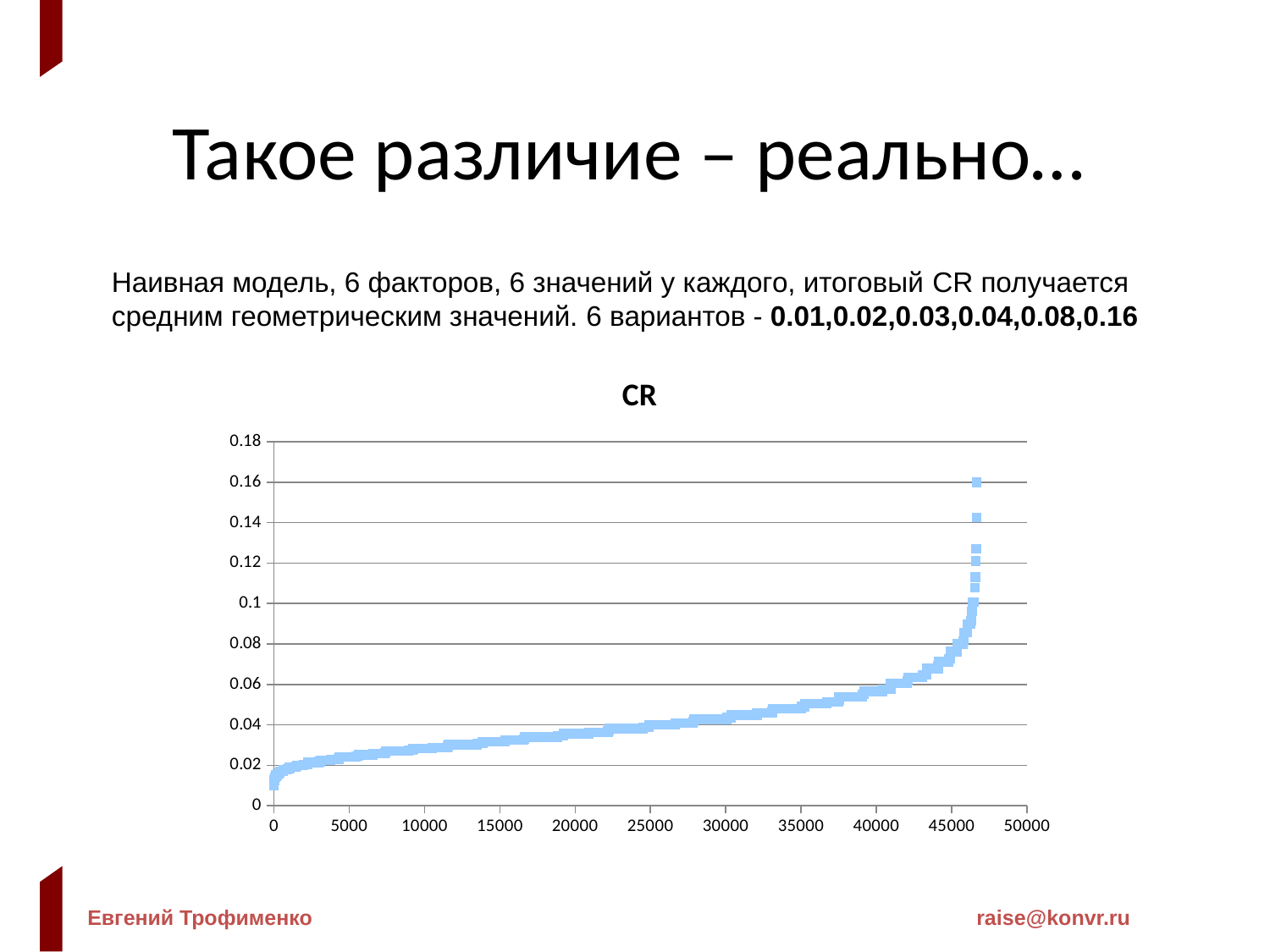
Is the plotted value at x = 30000 greater or less than 0.06? less What is the maximum value shown on the y axis? 0.18 Do the plotted values rise or fall as the x axis increases? rise Is the highest plotted value greater or less than 0.14? greater Is the plotted value at x = 40000 greater or less than 0.04? greater What kind of chart is shown on the slide? scatter chart What is the title of the chart? CR Which is larger: the plotted value at x = 5000 or at x = 35000? x = 35000